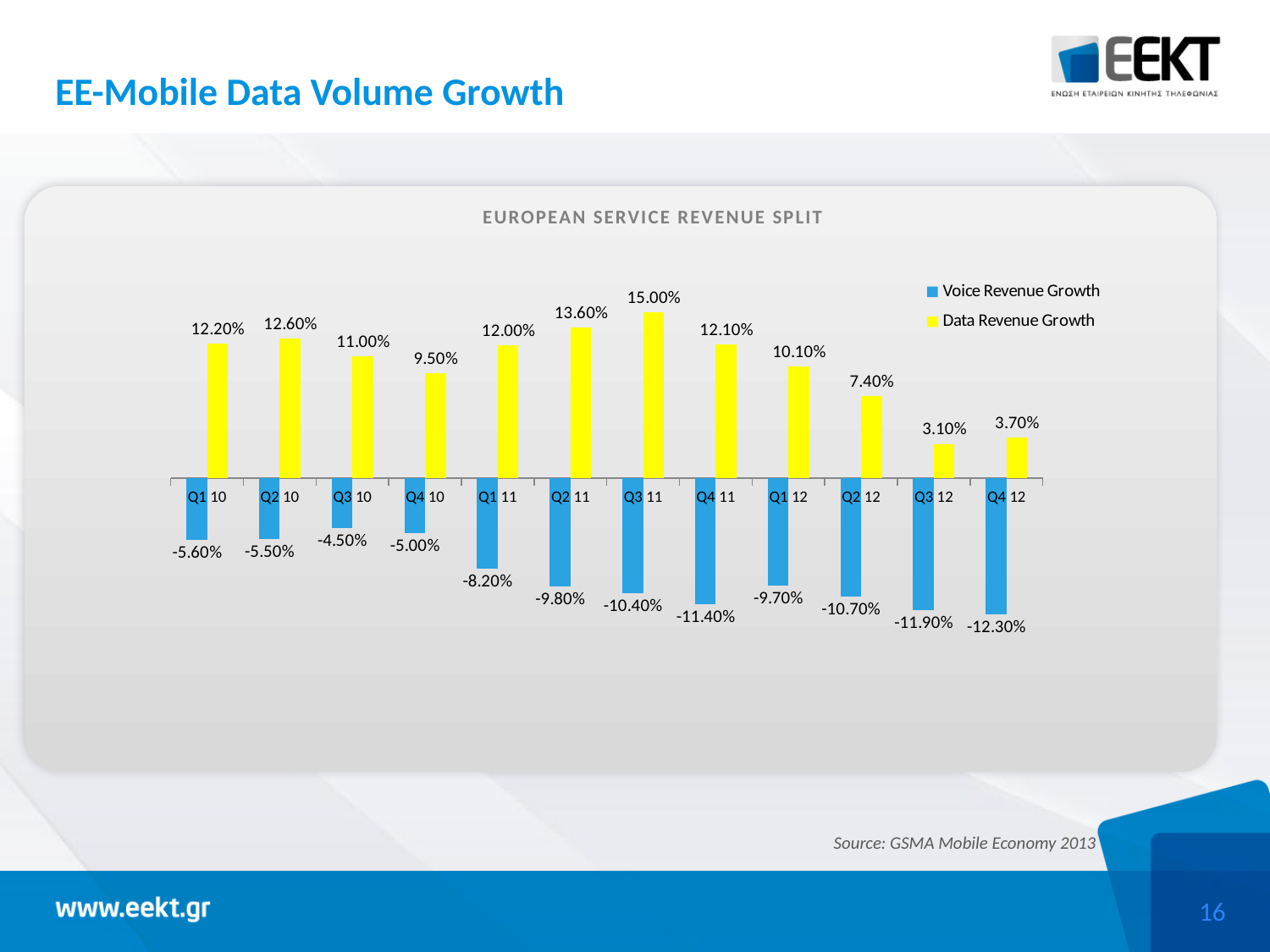
What kind of chart is shown on the slide? Bar chart How many quarters are shown on the x axis? 12 Which quarter has the lowest Voice Revenue Growth? Q4 12 What is the Voice Revenue Growth value for Q1 10? -5.60% What is the Data Revenue Growth value for Q2 12? 7.40% What is the Data Revenue Growth value for Q3 11? 15.00% Does Data Revenue Growth rise or fall from Q3 11 to Q3 12? Fall Which quarter has the lowest Data Revenue Growth? Q3 12 Which quarter has the highest Data Revenue Growth? Q3 11 What is the difference between the Data Revenue Growth values for Q2 10 and Q4 10? 3.10% How many series does the legend list? 2 Which is larger, the Data Revenue Growth for Q1 11 or for Q4 11? Q4 11